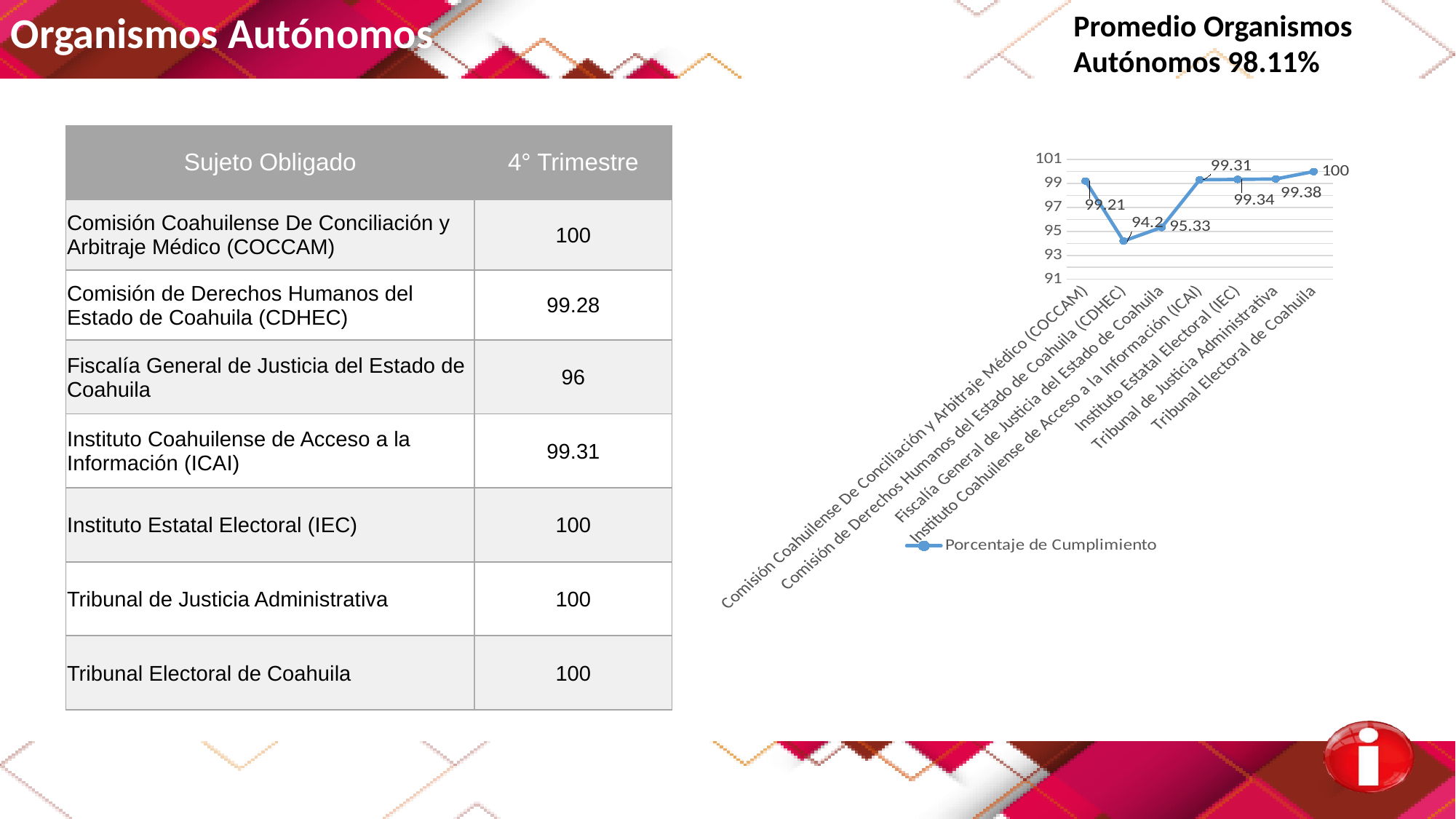
What is the difference between the value for Tribunal Electoral de Coahuila and the value for Comisión de Derechos Humanos del Estado de Coahuila (CDHEC)? 5.8 How many data points are plotted in the line chart? 7 What value does the chart show for Fiscalía General de Justicia del Estado de Coahuila? 95.33 Which category has the lowest value in the chart? Comisión de Derechos Humanos del Estado de Coahuila (CDHEC) Which category has the highest value in the chart? Tribunal Electoral de Coahuila Which has a larger value in the chart, Fiscalía General de Justicia del Estado de Coahuila or Instituto Coahuilense de Acceso a la Información (ICAI)? Instituto Coahuilense de Acceso a la Información (ICAI) What value does the chart show for Comisión de Derechos Humanos del Estado de Coahuila (CDHEC)? 94.2 What kind of chart is shown on the slide? line chart What is the name of the series shown in the chart legend? Porcentaje de Cumplimiento How many series does the chart legend list? 1 Is the value for Comisión de Derechos Humanos del Estado de Coahuila (CDHEC) greater or less than 97? less What value does the chart show for Tribunal de Justicia Administrativa? 99.38